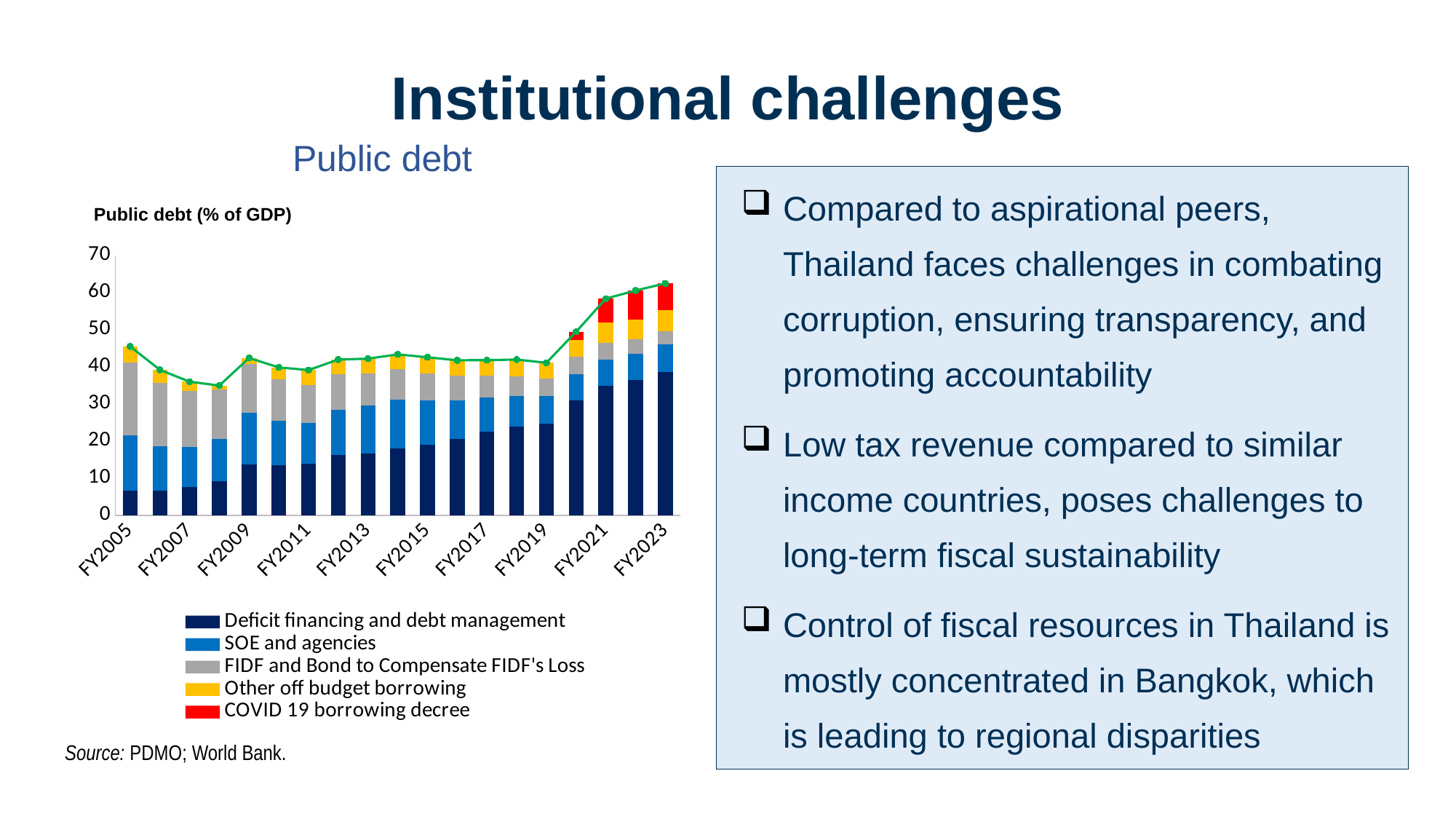
Which is larger, the total public debt in FY2005 or in FY2023? FY2023 Is the total public debt for FY2023 greater or less than 60? greater Which fiscal year has the highest total public debt (% of GDP) in the chart? FY2023 Is the 'Deficit financing and debt management' value for FY2023 greater or less than 40? less In which fiscal year does the 'COVID 19 borrowing decree' series first appear in the chart? FY2020 Does total public debt rise or fall from FY2019 to FY2023? Rise Is the 'Deficit financing and debt management' value for FY2005 greater or less than 10? less What kind of chart is used to show public debt on this slide? Stacked bar chart with a line How many fiscal years are plotted in the public debt chart? 19 How many series does the legend of the public debt chart list? 5 What is the title of the chart on the slide? Public debt (% of GDP)